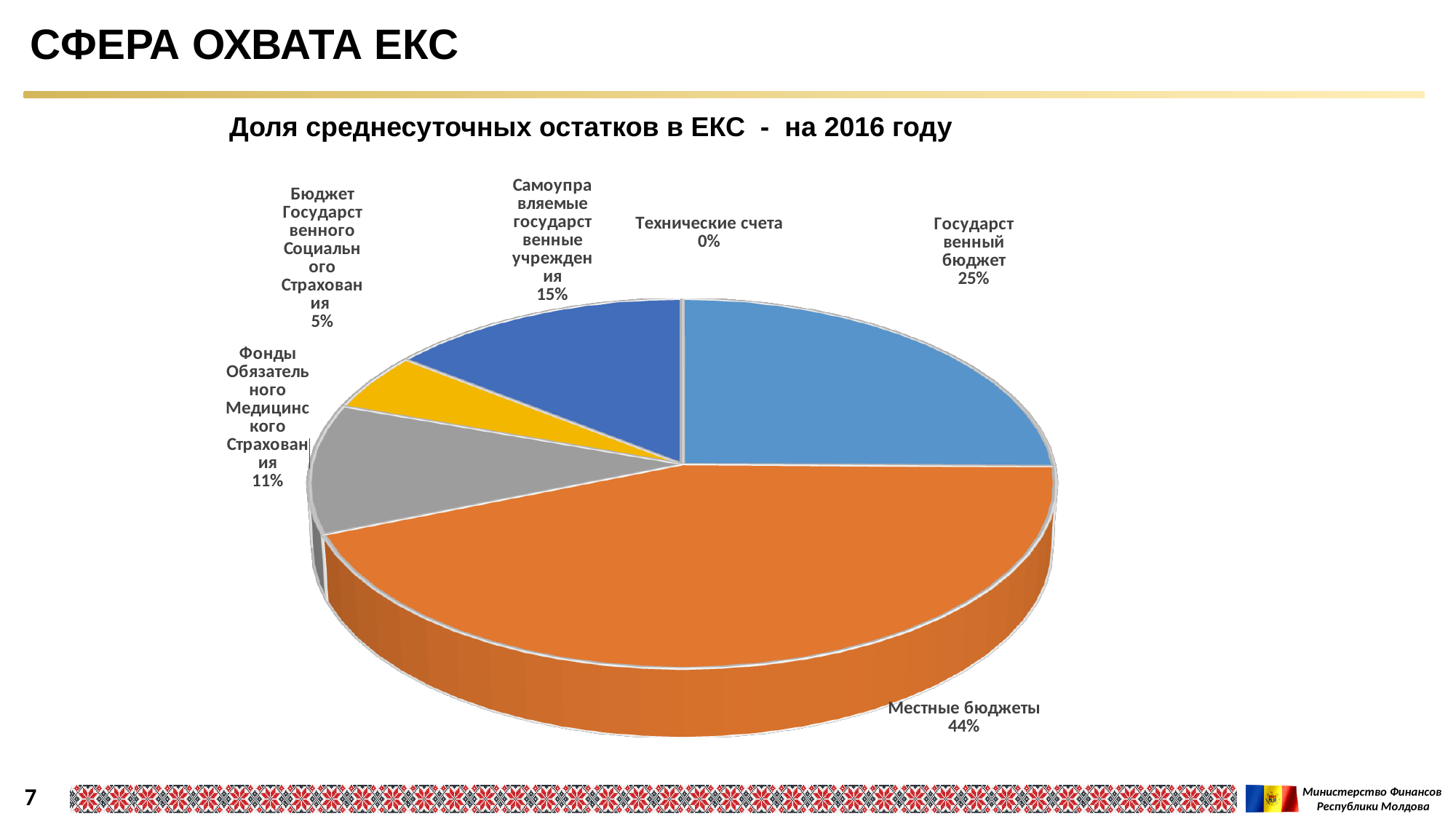
How many categories are shown in the pie chart? 6 What share does Самоуправляемые государственные учреждения hold in the pie chart? 15% What is the difference in percentage points between Местные бюджеты and Государственный бюджет? 19 percentage points What is the title of the chart? Доля среднесуточных остатков в ЕКС - на 2016 году What is the share of Бюджет Государственного Социального Страхования? 5% Which category has the smallest share of the pie? Технические счета Which category has the largest share of the pie? Местные бюджеты What is the share of Местные бюджеты in the pie chart? 44% What type of chart is shown on the slide? Pie chart What is the share of Государственный бюджет in the pie chart? 25% What is the share of Фонды Обязательного Медицинского Страхования? 11% What share is shown for Технические счета? 0%